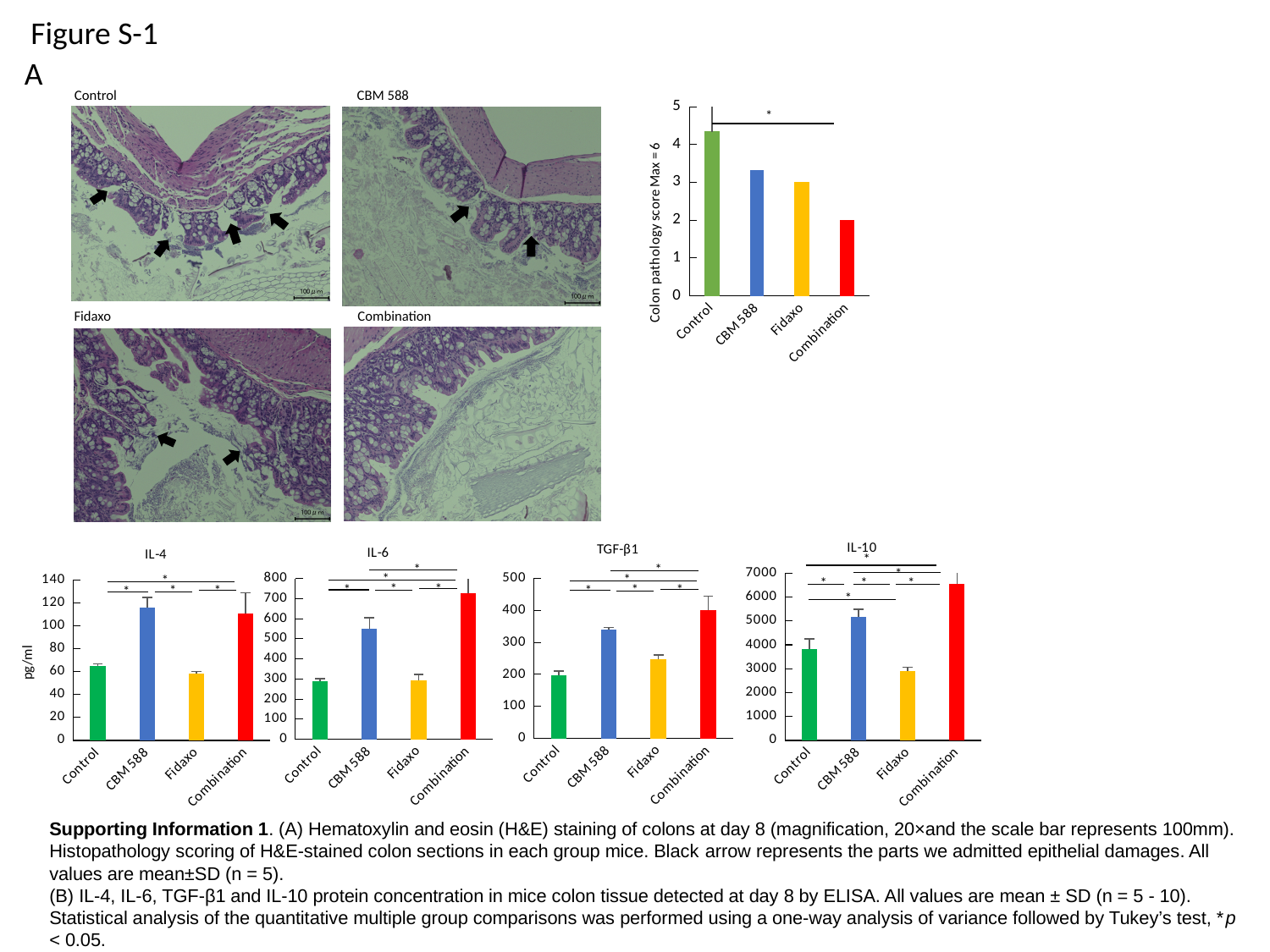
How many groups are shown on the x axis of the colon pathology score chart? 4 What is the y-axis label of the colon pathology score chart? Colon pathology score Max = 6 In the colon pathology score chart, which group has the highest score? Control In the TGF-β1 chart, which group has the lowest value? Control In the IL-6 chart, which group has the highest value? Combination What kind of chart is the IL-6 chart? bar chart In the IL-4 chart, is the value for CBM 588 greater or less than 100? greater In the colon pathology score chart, is the value for Control greater or less than 4? greater In the colon pathology score chart, which group has the lowest score? Combination In the IL-10 chart, which group has the lowest value? Fidaxo In the colon pathology score chart, is the value for Combination greater or less than 3? less